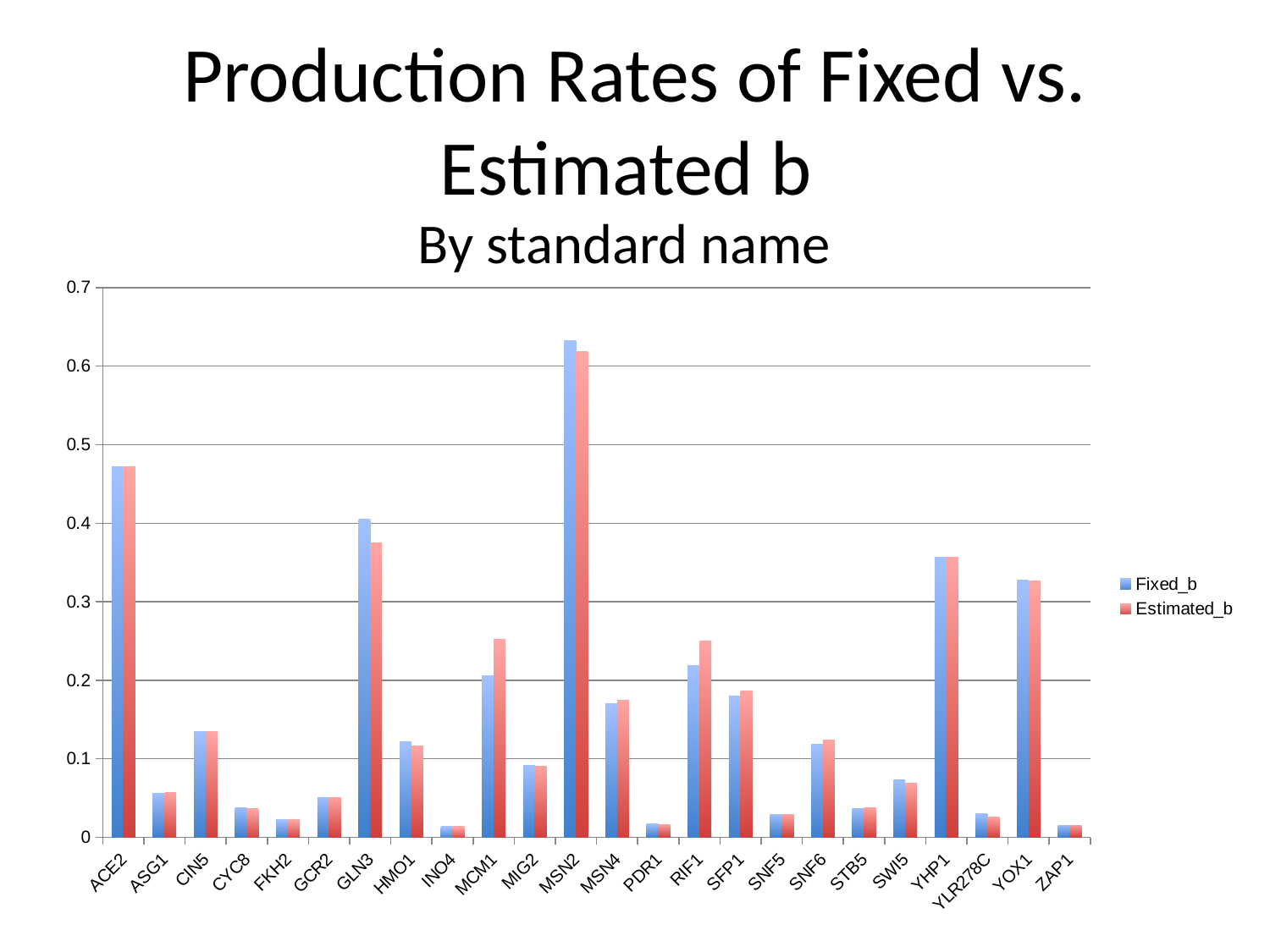
For MCM1, which is larger: Fixed_b or Estimated_b? Estimated_b How many categories (standard names) are shown on the x axis? 24 How many series does the legend list? 2 Is the Estimated_b value for GLN3 greater or less than 0.4? less Is the Fixed_b value for SWI5 greater or less than 0.1? less Is the Fixed_b value for MSN2 greater or less than 0.6? greater What are the two legend entries of the chart? Fixed_b and Estimated_b What kind of chart is shown on the slide? bar chart For GLN3, which is larger: Fixed_b or Estimated_b? Fixed_b Which category has the highest Estimated_b value? MSN2 Which category has the highest Fixed_b value? MSN2